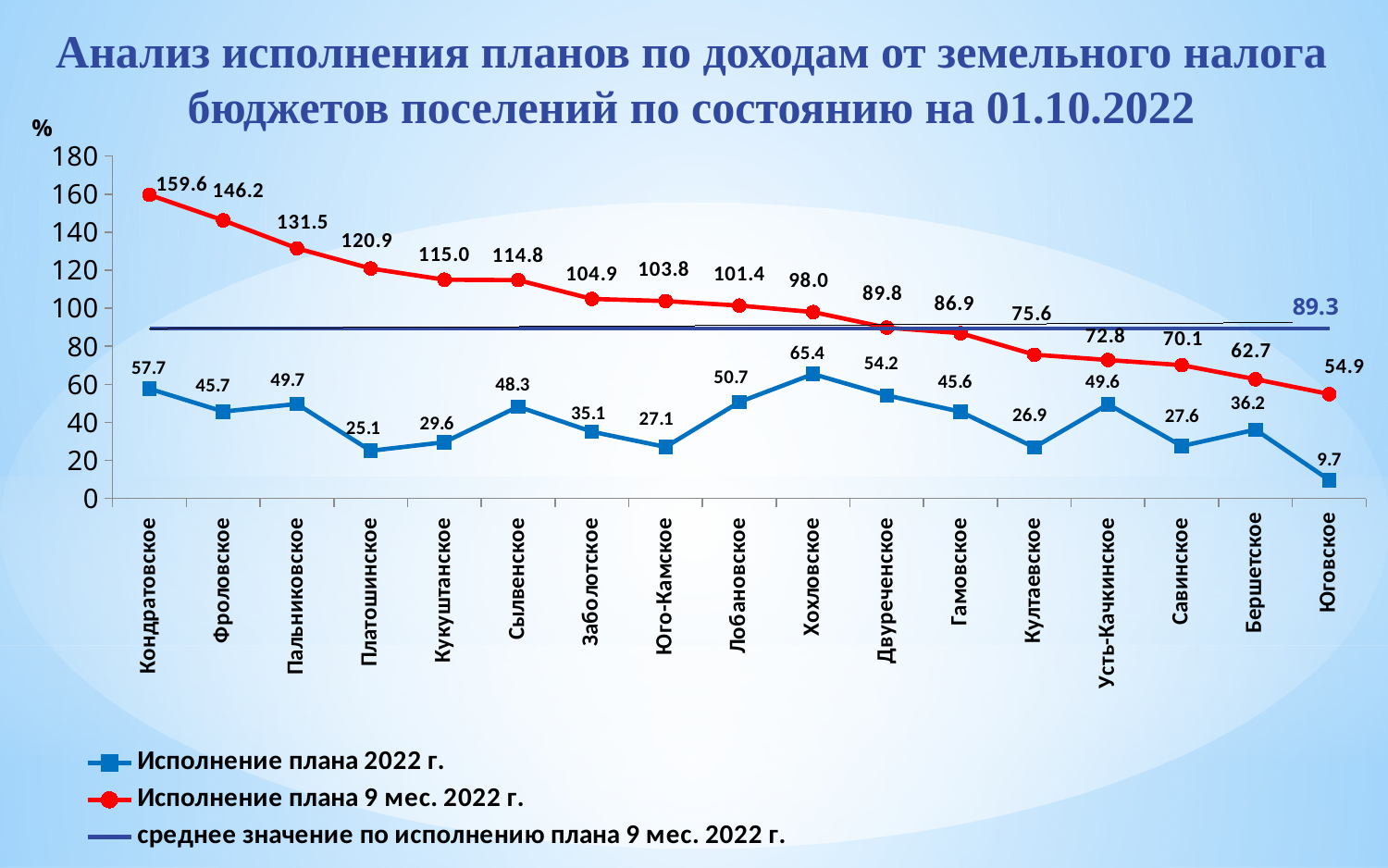
What is the value of the line "среднее значение по исполнению плана 9 мес. 2022 г."? 89.3 Does the "Исполнение плана 9 мес. 2022 г." series rise or fall from left to right along the x axis? fall How many series does the legend list? 3 Which settlement has the lowest value for "Исполнение плана 2022 г."? Юговское What is the difference between the "Исполнение плана 9 мес. 2022 г." values for Фроловское and Пальниковское? 14.7 Which is larger: the "Исполнение плана 2022 г." value for Сылвенское or for Заболотское? Сылвенское Is the "Исполнение плана 9 мес. 2022 г." value for Двуреченское greater or less than 100? less What is the value of "Исполнение плана 9 мес. 2022 г." for Кондратовское? 159.6 Which settlement has the highest value for "Исполнение плана 9 мес. 2022 г."? Кондратовское How many settlements are shown on the x axis? 17 What kind of chart is shown on the slide? line chart What is the value of "Исполнение плана 2022 г." for Хохловское? 65.4